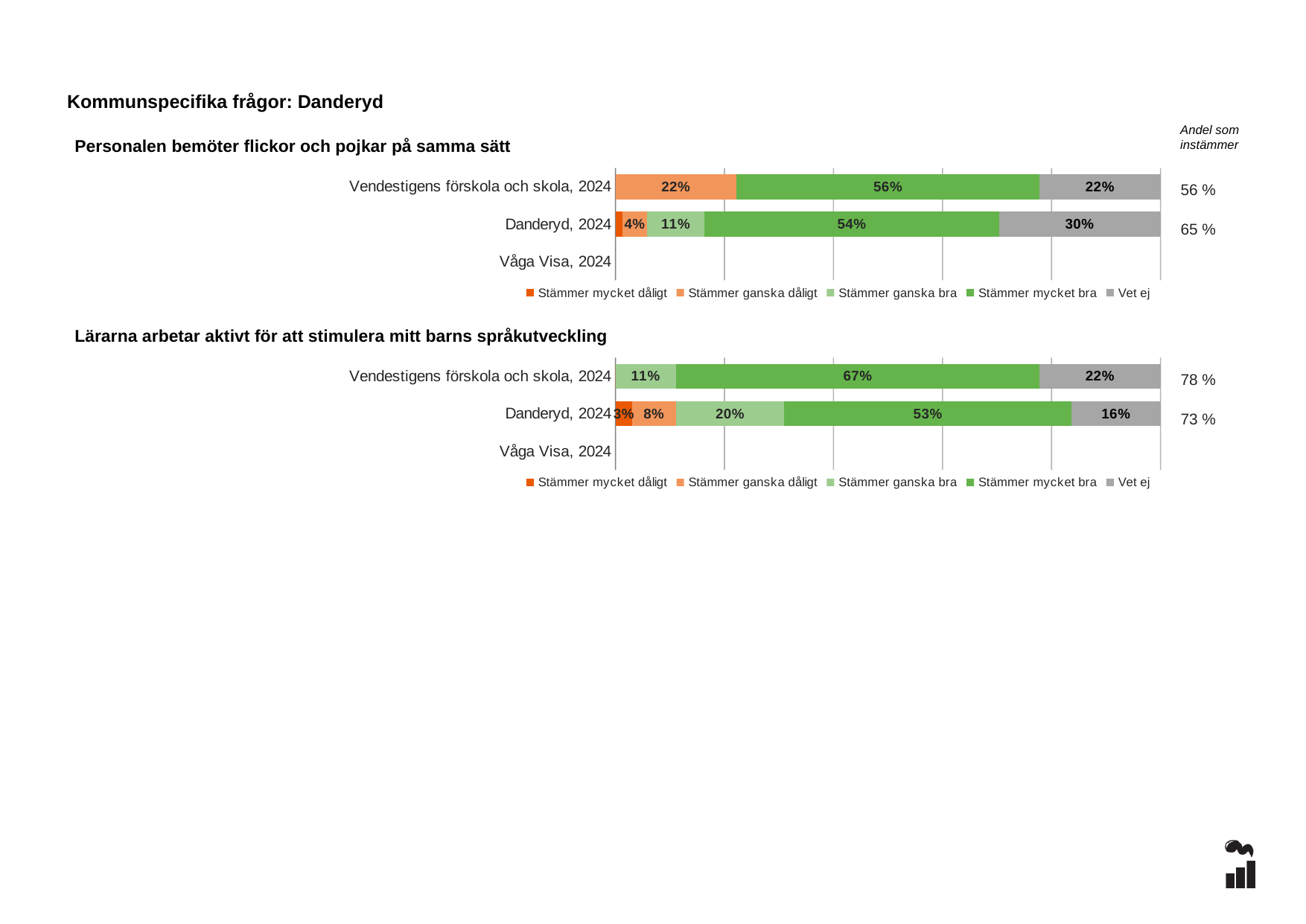
In the chart 'Lärarna arbetar aktivt för att stimulera mitt barns språkutveckling', what is the 'Andel som instämmer' value shown for Vendestigens förskola och skola, 2024? 78 % How many series does the legend list in the chart 'Lärarna arbetar aktivt för att stimulera mitt barns språkutveckling'? 5 In the chart 'Lärarna arbetar aktivt för att stimulera mitt barns språkutveckling', what is the difference between the 'Stämmer mycket bra' values for Vendestigens förskola och skola, 2024 and Danderyd, 2024? 14% What kind of chart is 'Personalen bemöter flickor och pojkar på samma sätt'? Stacked bar chart In the chart 'Personalen bemöter flickor och pojkar på samma sätt', what is the 'Vet ej' value for Danderyd, 2024? 30% In the chart 'Personalen bemöter flickor och pojkar på samma sätt', which has the larger 'Stämmer mycket bra' value: Vendestigens förskola och skola, 2024 or Danderyd, 2024? Vendestigens förskola och skola, 2024 In the chart 'Personalen bemöter flickor och pojkar på samma sätt', what is the difference between the 'Vet ej' values for Danderyd, 2024 and Vendestigens förskola och skola, 2024? 8% In the chart 'Lärarna arbetar aktivt för att stimulera mitt barns språkutveckling', what is the 'Stämmer mycket bra' value for Vendestigens förskola och skola, 2024? 67% In the chart 'Personalen bemöter flickor och pojkar på samma sätt', what is the 'Stämmer mycket bra' value for Vendestigens förskola och skola, 2024? 56% In the chart 'Personalen bemöter flickor och pojkar på samma sätt', what is the 'Andel som instämmer' value shown for Danderyd, 2024? 65 % In the chart 'Personalen bemöter flickor och pojkar på samma sätt', which legend entry is shown in grey? Vet ej In the chart 'Lärarna arbetar aktivt för att stimulera mitt barns språkutveckling', what is the 'Stämmer ganska bra' value for Danderyd, 2024? 20%